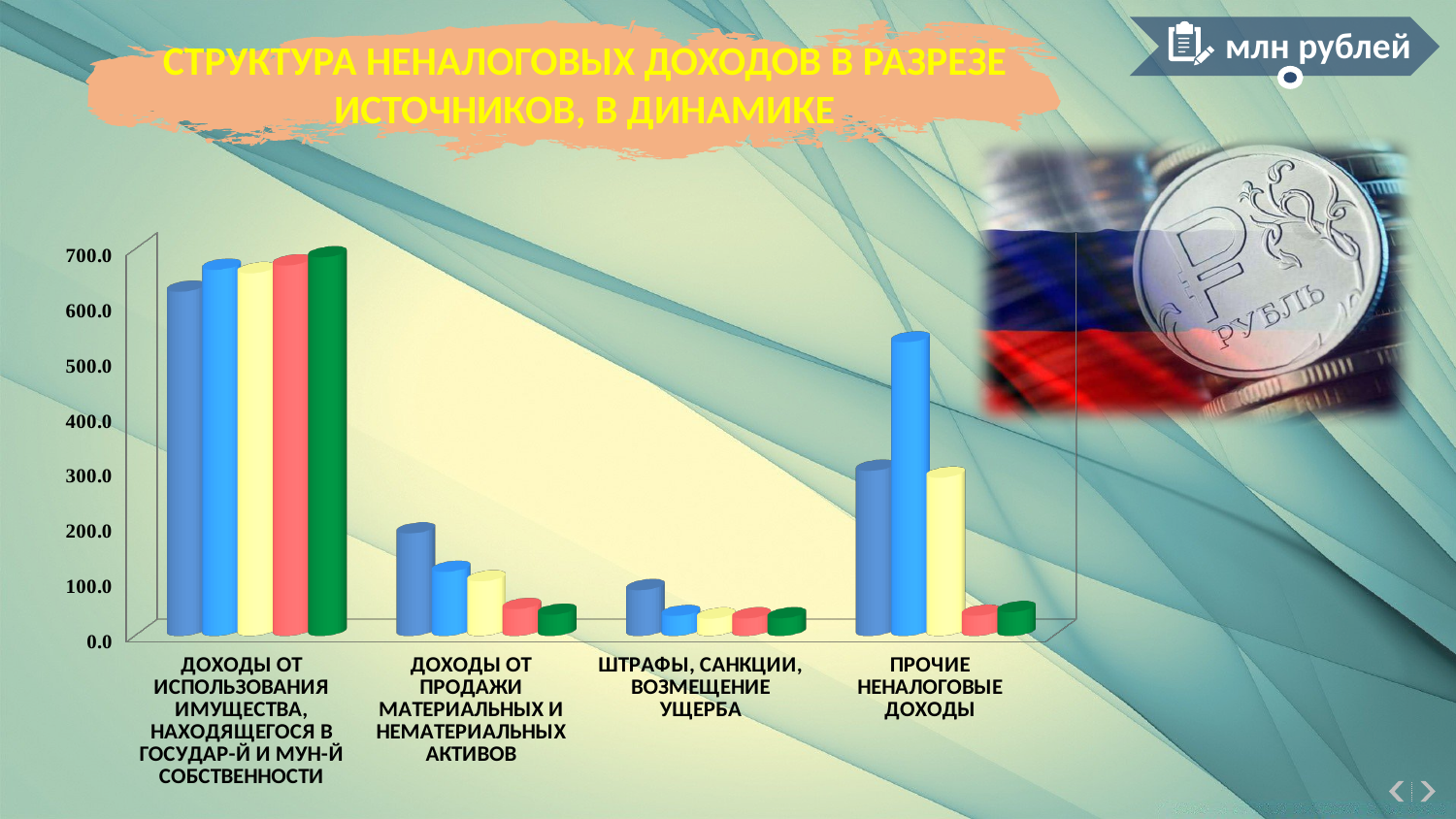
Is the value of the red bar for ПРОЧИЕ НЕНАЛОГОВЫЕ ДОХОДЫ greater or less than 100.0? less Which category has the lowest bars overall in the chart? ШТРАФЫ, САНКЦИИ, ВОЗМЕЩЕНИЕ УЩЕРБА In what units are the values on the chart expressed, according to the slide? млн рублей Which category has the tallest bars overall in the chart? ДОХОДЫ ОТ ИСПОЛЬЗОВАНИЯ ИМУЩЕСТВА, НАХОДЯЩЕГОСЯ В ГОСУДАР-Й И МУН-Й СОБСТВЕННОСТИ What kind of chart is shown on the slide? bar chart What is the title of the chart on the slide? СТРУКТУРА НЕНАЛОГОВЫХ ДОХОДОВ В РАЗРЕЗЕ ИСТОЧНИКОВ, В ДИНАМИКЕ How many bars are plotted for each category in the chart? 5 For ДОХОДЫ ОТ ПРОДАЖИ МАТЕРИАЛЬНЫХ И НЕМАТЕРИАЛЬНЫХ АКТИВОВ, which bar is taller: the dark blue bar or the red bar? the dark blue bar Are all the bars for ШТРАФЫ, САНКЦИИ, ВОЗМЕЩЕНИЕ УЩЕРБА greater or less than 200.0? less Is the value of the green bar for ДОХОДЫ ОТ ИСПОЛЬЗОВАНИЯ ИМУЩЕСТВА greater or less than 600.0? greater How many categories are shown on the x axis of the chart? 4